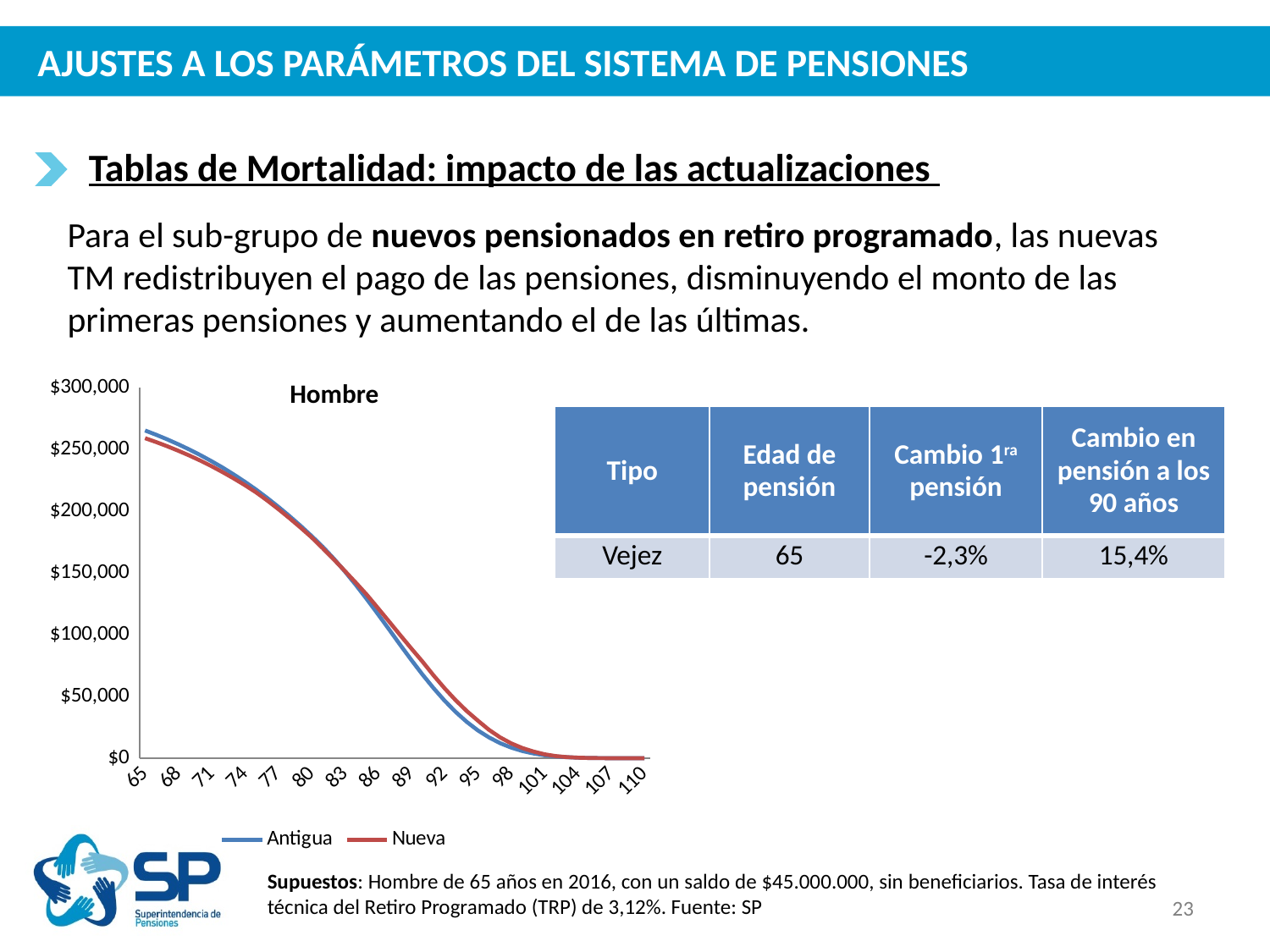
Do the values of the Nueva series rise or fall as age increases along the x axis? fall How many series does the chart legend list? 2 At age 92, which series has the larger value, Antigua or Nueva? Nueva Do the values of the Antigua series rise or fall as age increases along the x axis? fall Is the value of the Nueva series at age 95 greater or less than $50,000? less Is the value of the Nueva series at age 80 greater or less than $150,000? greater What kind of chart is shown on the slide? line chart What is the title of the chart? Hombre Is the value of the Antigua series at age 80 greater or less than $200,000? less What are the names of the two series in the chart legend? Antigua and Nueva At age 65, which series has the larger value, Antigua or Nueva? Antigua